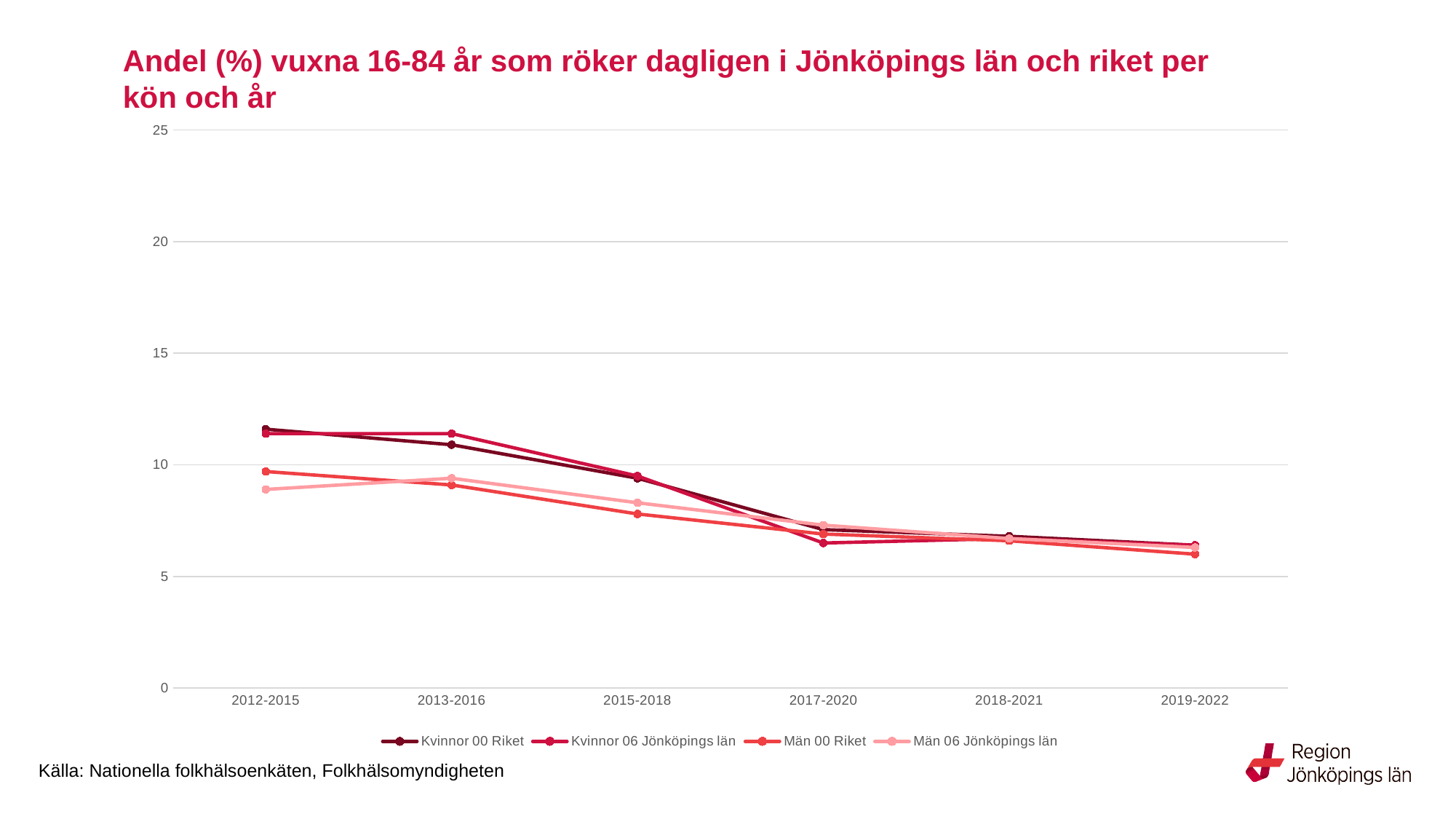
In 2012-2015, which is larger: the value for Kvinnor 00 Riket or the value for Män 00 Riket? Kvinnor 00 Riket How many series does the legend list? 4 Is the value for Kvinnor 06 Jönköpings län in 2013-2016 greater or less than 10? greater Is the value for Kvinnor 00 Riket in 2012-2015 greater or less than 10? greater What kind of chart is shown on the slide? line chart Which series has the highest value in 2013-2016? Kvinnor 06 Jönköpings län Which series has the lowest value in 2012-2015? Män 06 Jönköpings län Is the value for Män 06 Jönköpings län in 2012-2015 greater or less than 10? less What is the source cited below the chart? Nationella folkhälsoenkäten, Folkhälsomyndigheten How many time periods are shown on the x axis? 6 Do the values for Kvinnor 00 Riket rise or fall from 2012-2015 to 2019-2022? fall